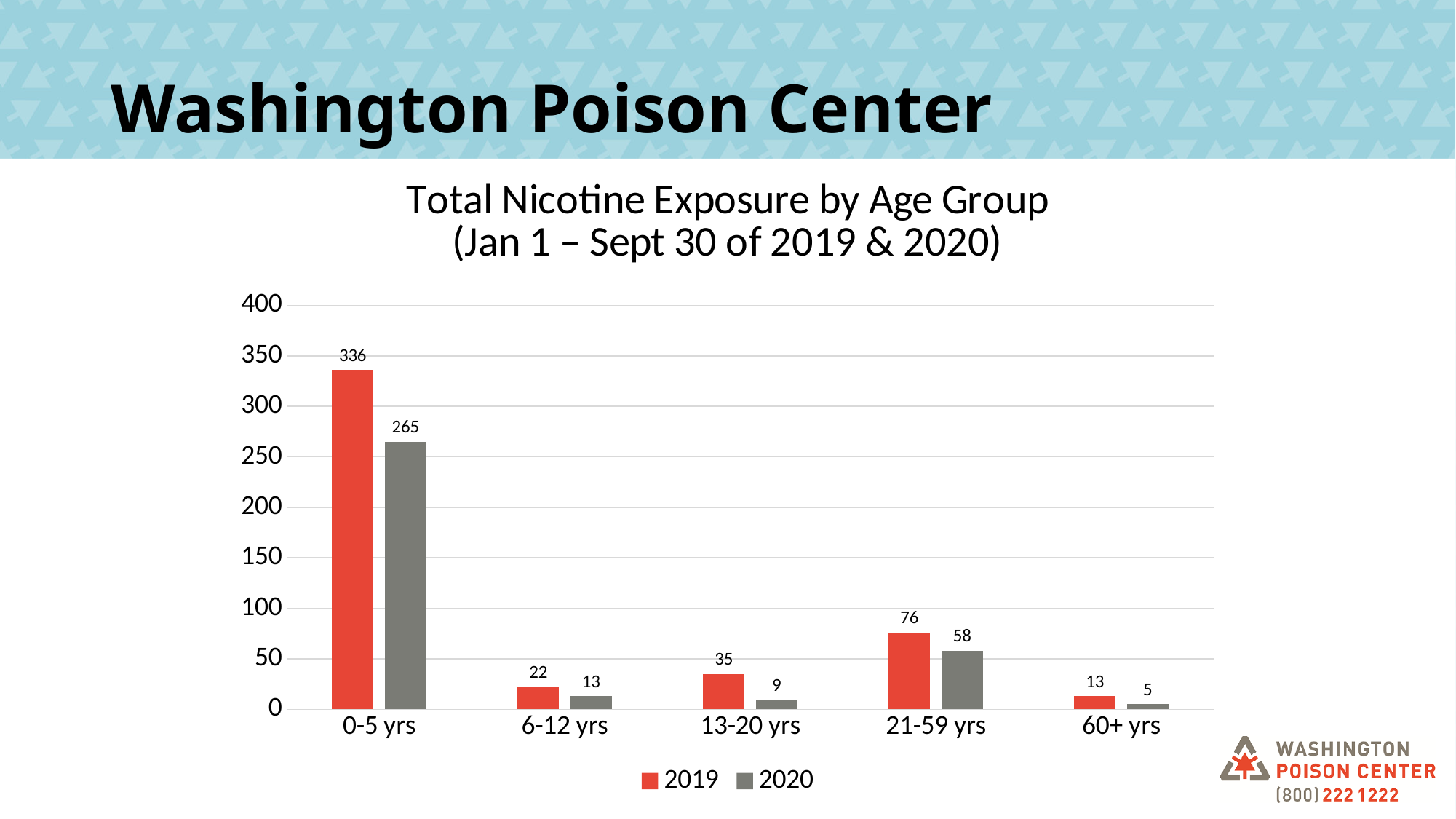
What is the title of the chart? Total Nicotine Exposure by Age Group (Jan 1 – Sept 30 of 2019 & 2020) What kind of chart is shown on the slide? Bar chart How many age groups are shown on the x axis? 5 Which age group has the highest 2019 value? 0-5 yrs What is the 2019 value for the 0-5 yrs age group? 336 Is the 2020 value for the 0-5 yrs age group greater or less than 250? greater What is the difference between the 2019 and 2020 values for the 0-5 yrs age group? 71 What is the 2020 value for the 21-59 yrs age group? 58 Which is larger for the 6-12 yrs age group, the 2019 value or the 2020 value? 2019 How many series does the legend list? 2 What is the 2020 value for the 13-20 yrs age group? 9 Which age group has the lowest 2020 value? 60+ yrs